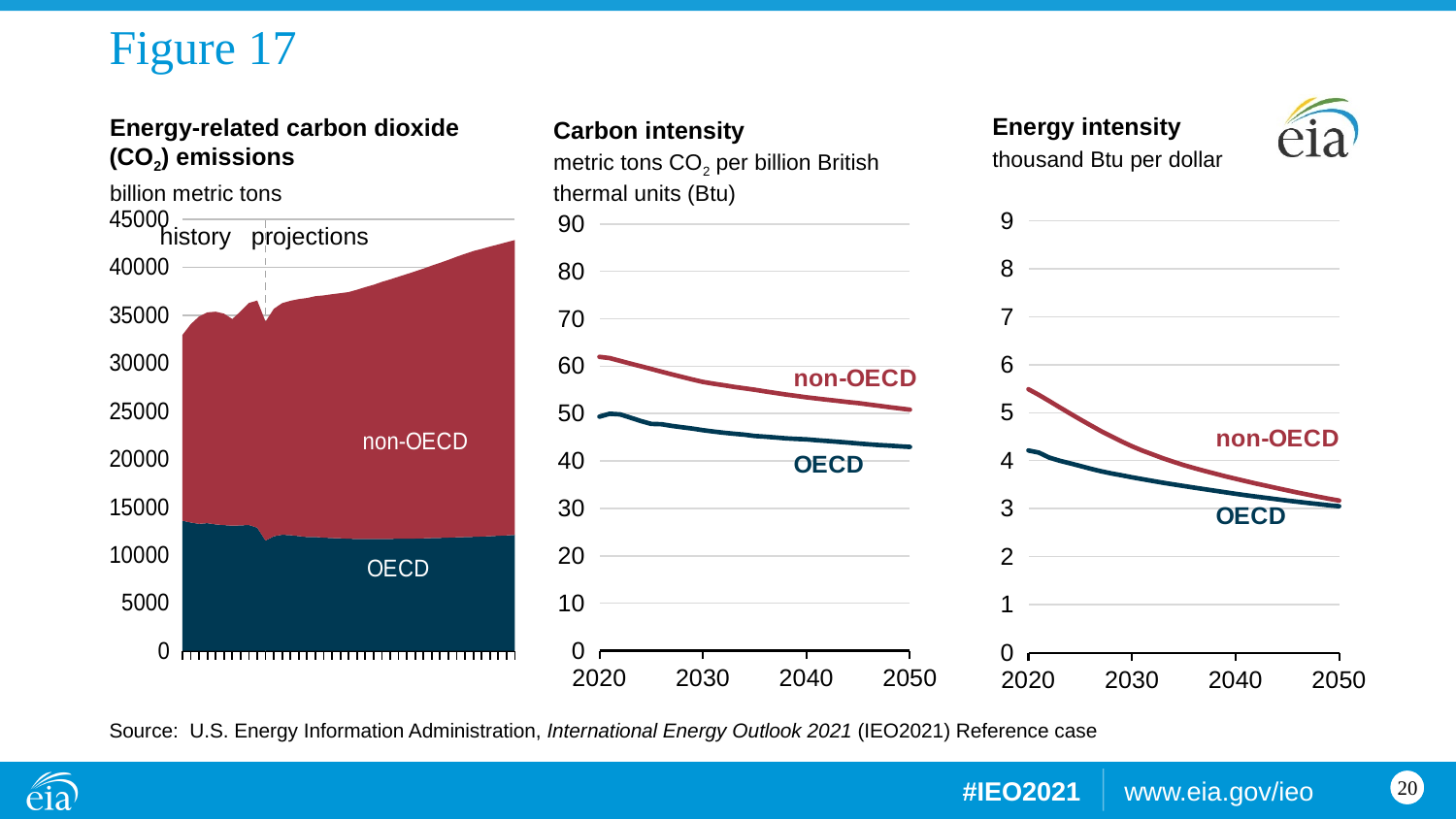
In the 'Carbon intensity' chart, which series is higher in 2050, non-OECD or OECD? non-OECD In the 'Energy intensity' chart, is the non-OECD value in 2020 greater or less than 5? greater In the 'Energy intensity' chart, is the non-OECD value in 2050 greater or less than 4? less In the 'Carbon intensity' chart, does the non-OECD line rise or fall from 2020 to 2050? fall In the 'Carbon intensity' chart, is the OECD value in 2050 greater or less than 40? greater In the 'Carbon intensity' chart, how many series are plotted? 2 In the 'Energy intensity' chart, which series is higher in 2030, non-OECD or OECD? non-OECD In the 'Energy-related carbon dioxide (CO2) emissions' chart, which region accounts for the larger share of emissions, non-OECD or OECD? non-OECD What kind of chart is the 'Carbon intensity' chart in the middle? line chart What kind of chart is the 'Energy-related carbon dioxide (CO2) emissions' chart on the left? stacked area chart What unit is shown under the 'Energy intensity' chart title? thousand Btu per dollar